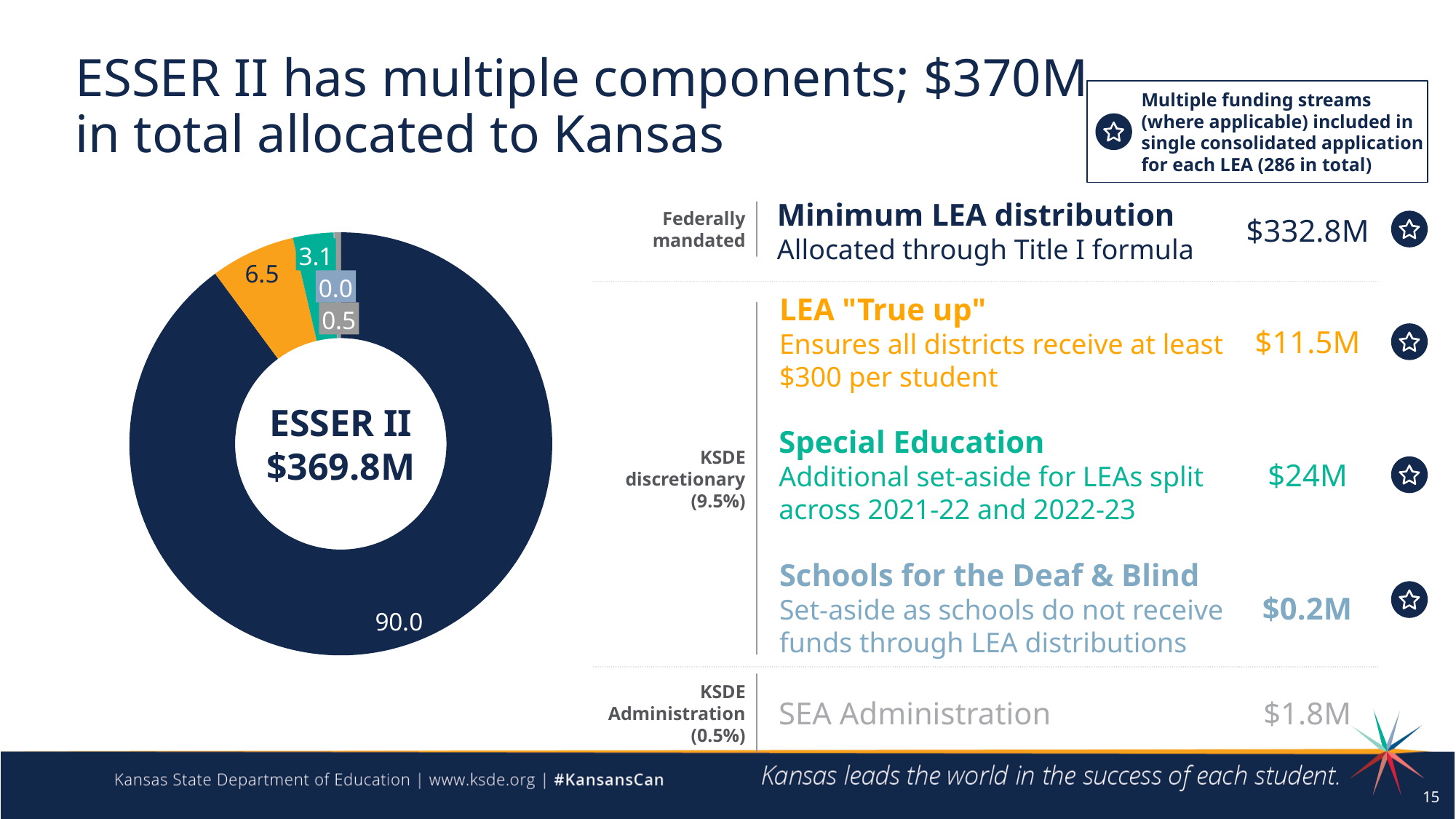
What is the value printed on the light blue slice of the donut chart? 0.0 What is the difference between the values of the dark navy slice and the orange slice on the donut chart? 83.5 Which slice has the larger value on the donut chart, the orange slice or the teal slice? The orange slice (6.5) How many slices are labelled on the donut chart? 5 What is the value printed on the teal slice of the donut chart? 3.1 What kind of chart is shown on the left of the slide? Pie chart (donut) What is the value printed on the orange slice of the donut chart? 6.5 What is the value printed on the grey slice of the donut chart? 0.5 What is the difference between the values of the teal slice and the grey slice on the donut chart? 2.6 What is the value printed on the largest slice of the donut chart? 90.0 What total amount is printed in the centre of the donut chart? $369.8M What label is printed in the centre of the donut chart above the dollar amount? ESSER II